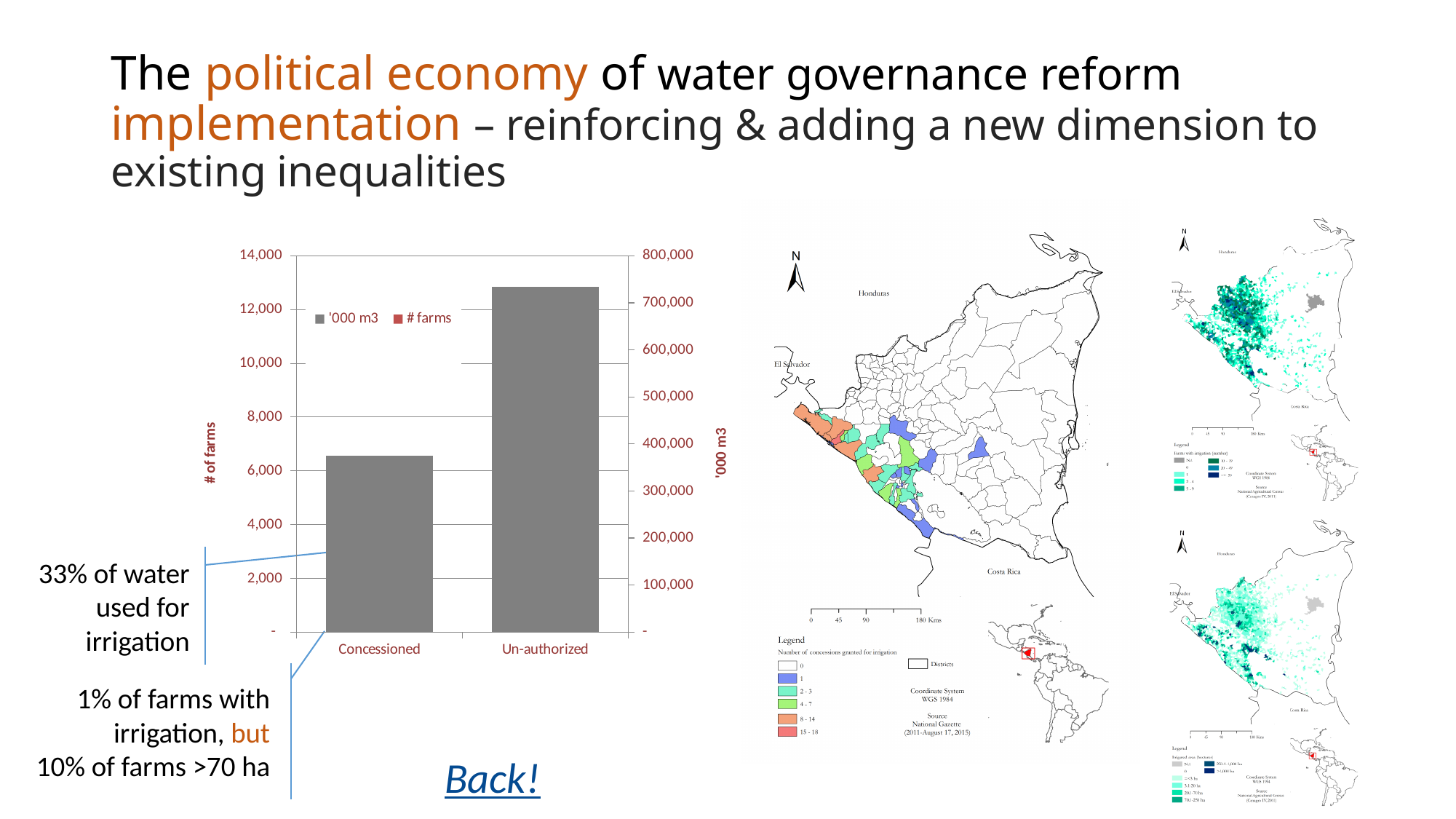
On the right-hand '000 m3 axis, is the value for Un-authorized greater or less than 700,000? greater Which category has the taller bar in the bar chart, Concessioned or Un-authorized? Un-authorized What is the label of the left vertical axis of the bar chart? # of farms How many series does the legend of the bar chart list? 2 How many categories are shown on the x axis of the bar chart? 2 Which category has the lowest bar in the bar chart? Concessioned Which category has the highest bar in the bar chart? Un-authorized On the right-hand '000 m3 axis, is the value for Concessioned greater or less than 500,000? less What kind of chart is shown on the left of the slide? bar chart Do the bar values rise or fall going from Concessioned to Un-authorized? rise What is the label of the right vertical axis of the bar chart? '000 m3 On the right-hand '000 m3 axis, is the value for Concessioned greater or less than 300,000? greater